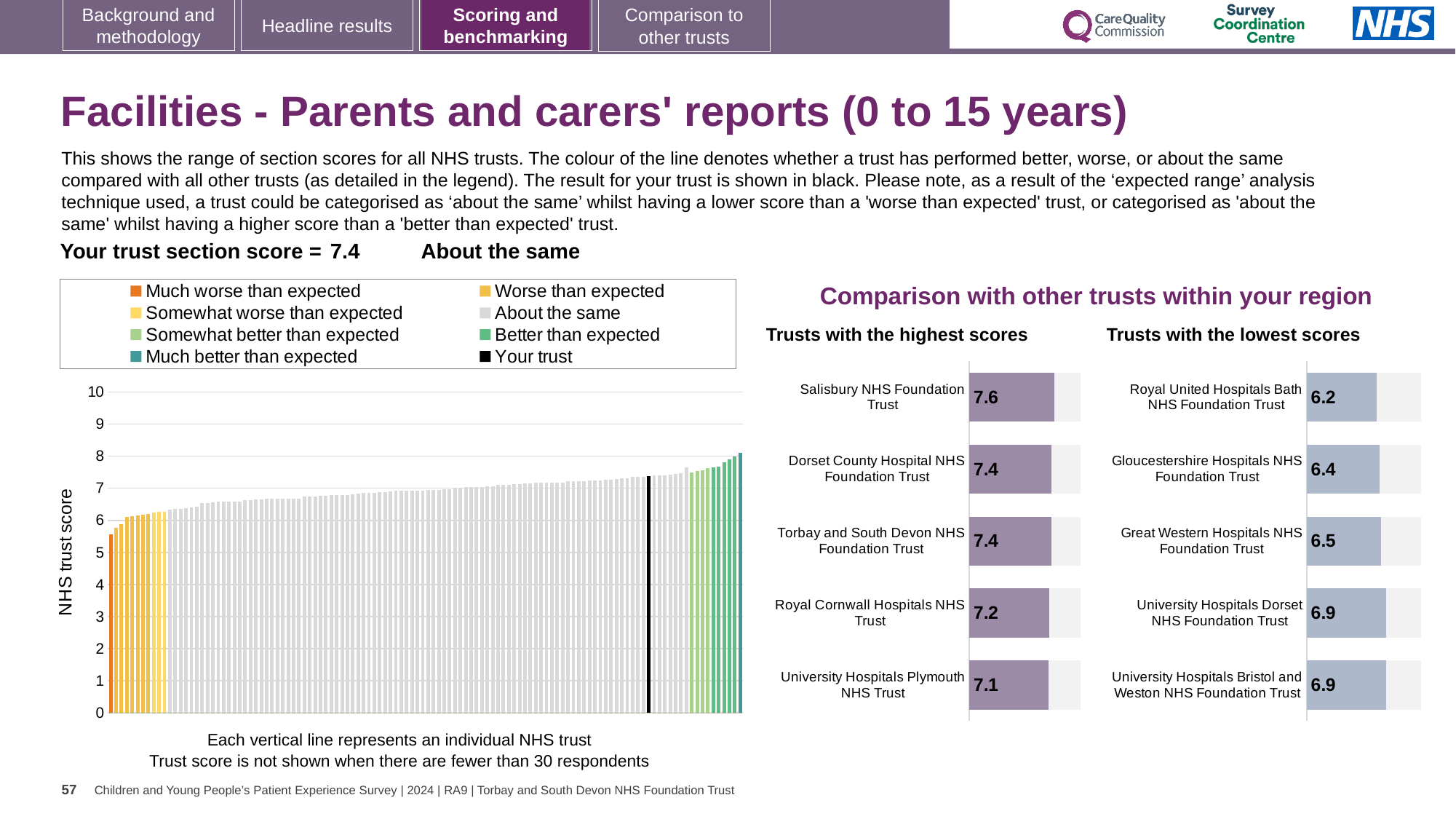
How many trusts are shown in the 'Trusts with the highest scores' chart? 5 In the 'Trusts with the lowest scores' chart, which trust has the lowest score? Royal United Hospitals Bath NHS Foundation Trust In the 'Trusts with the highest scores' chart, what is the score for Royal Cornwall Hospitals NHS Trust? 7.2 In the 'Trusts with the lowest scores' chart, what is the score for Royal United Hospitals Bath NHS Foundation Trust? 6.2 How many entries does the legend of the main chart on the left list? 8 In the main chart on the left, do the trust scores rise or fall from left to right along the x axis? Rise In the 'Trusts with the lowest scores' chart, which has the larger score: Gloucestershire Hospitals NHS Foundation Trust or Great Western Hospitals NHS Foundation Trust? Great Western Hospitals NHS Foundation Trust What is the label on the vertical axis of the main chart on the left? NHS trust score What kind of chart is the main chart on the left showing all NHS trusts? Bar chart In the 'Trusts with the highest scores' chart, what is the score for Salisbury NHS Foundation Trust? 7.6 In the 'Trusts with the highest scores' chart, what is the difference between the scores of Salisbury NHS Foundation Trust and University Hospitals Plymouth NHS Trust? 0.5 In the 'Trusts with the highest scores' chart, which trust has the highest score? Salisbury NHS Foundation Trust